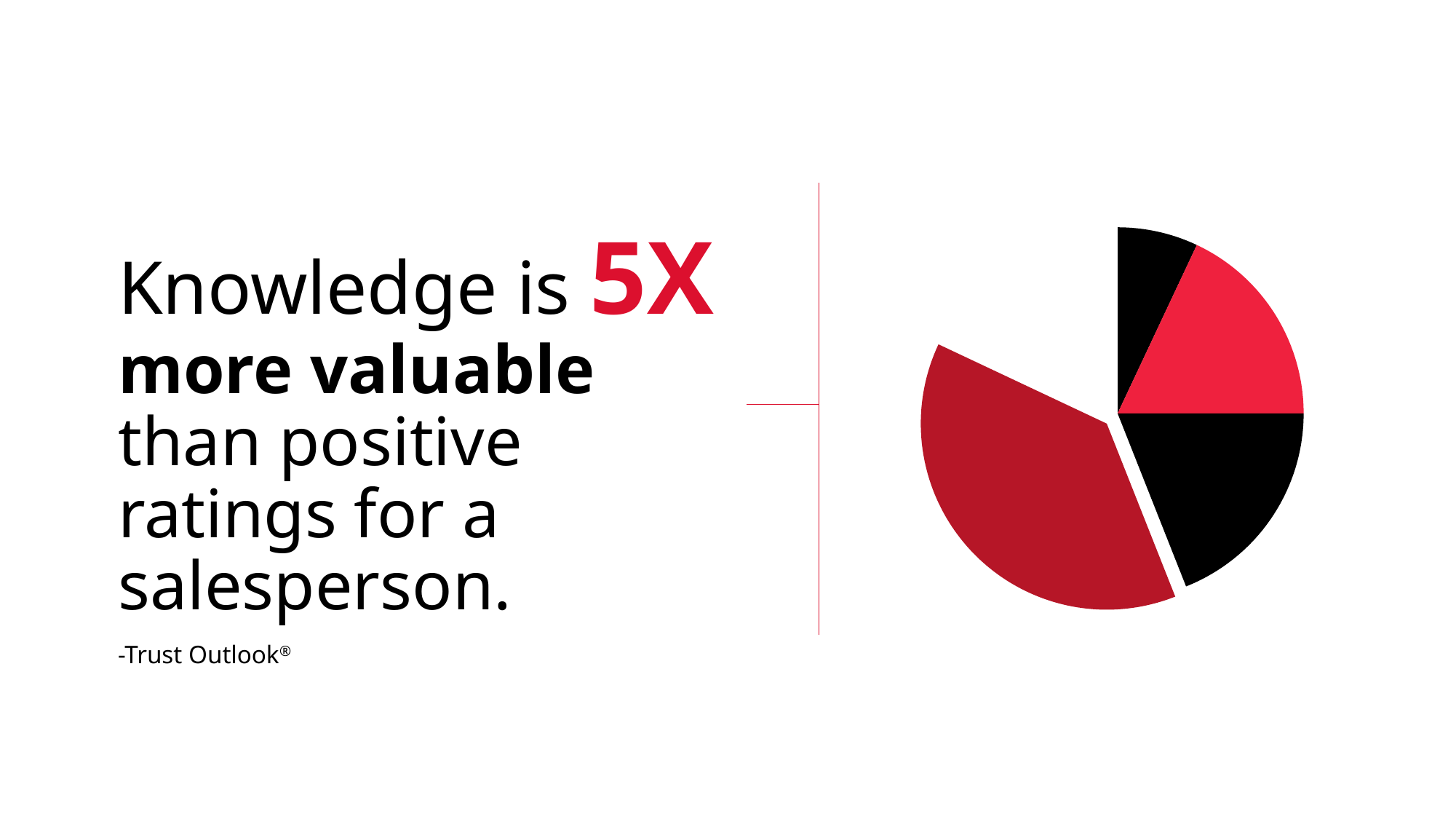
Is the dark red slice of the pie chart larger or smaller than the bright red slice? larger Which slice of the pie chart is pulled out (exploded) from the rest of the pie? the dark red slice on the left What kind of chart is shown on the right side of the slide? pie chart Does the pie chart show a legend? No Which slice of the pie chart is the largest? the dark red slice on the left Which slice of the pie chart is the smallest? the small black slice at the top Is the black slice at the bottom right of the pie chart larger or smaller than the small black slice at the top? larger